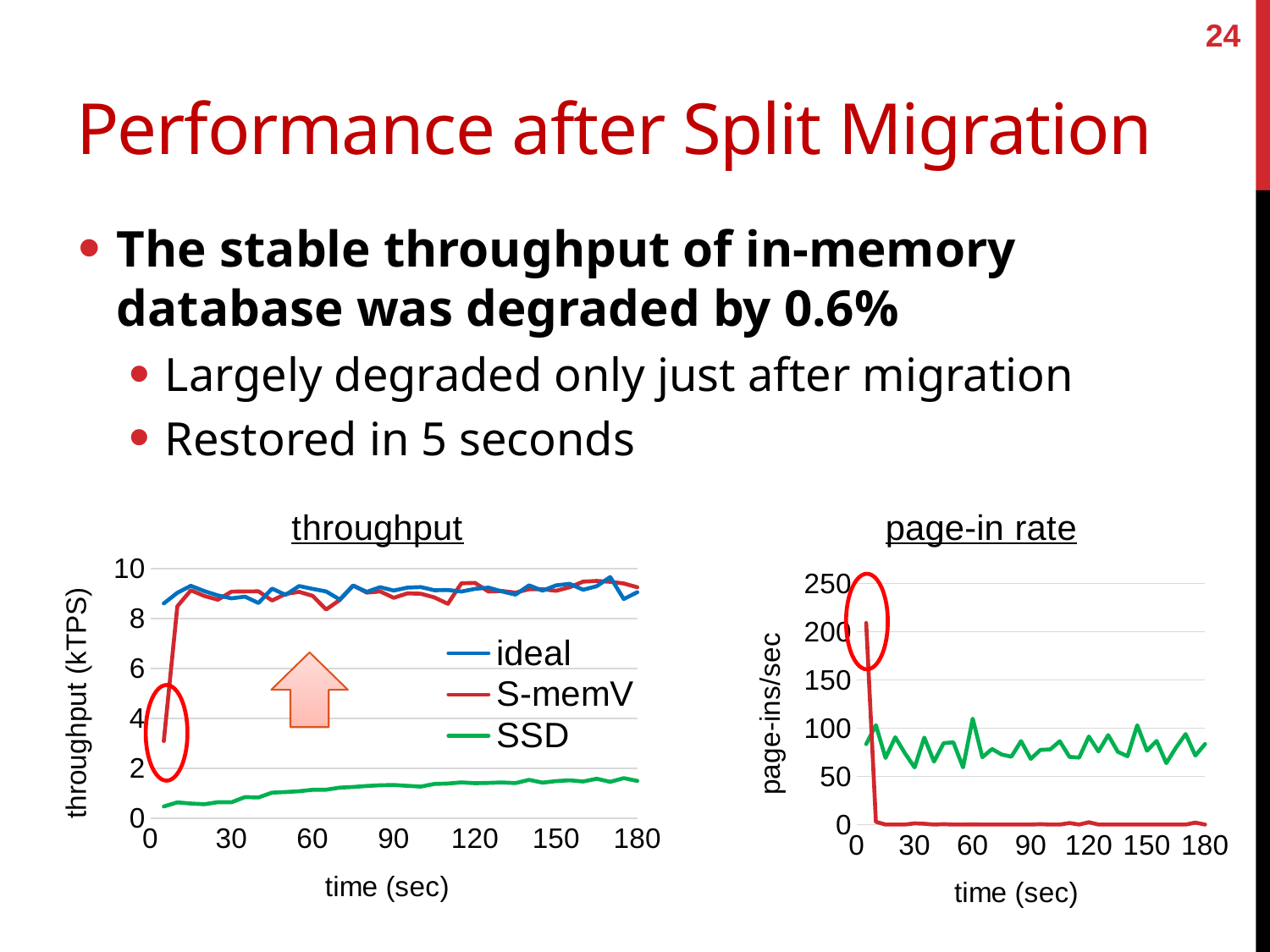
In the throughput chart, which is larger at 180 sec, ideal or SSD? ideal In the throughput chart, does the SSD line rise or fall from 0 to 180 sec? rises What is the y-axis label of the page-in rate chart? page-ins/sec In the page-in rate chart, is the peak of the red line greater or less than 150? greater In the throughput chart, is the value for ideal at 90 sec greater or less than 8? greater What kind of chart is the throughput chart? line chart In the page-in rate chart, is the value of the green line at 90 sec greater or less than 150? less What are the legend entries of the throughput chart? ideal, S-memV, SSD What kind of chart is the page-in rate chart? line chart How many series does the legend of the throughput chart list? 3